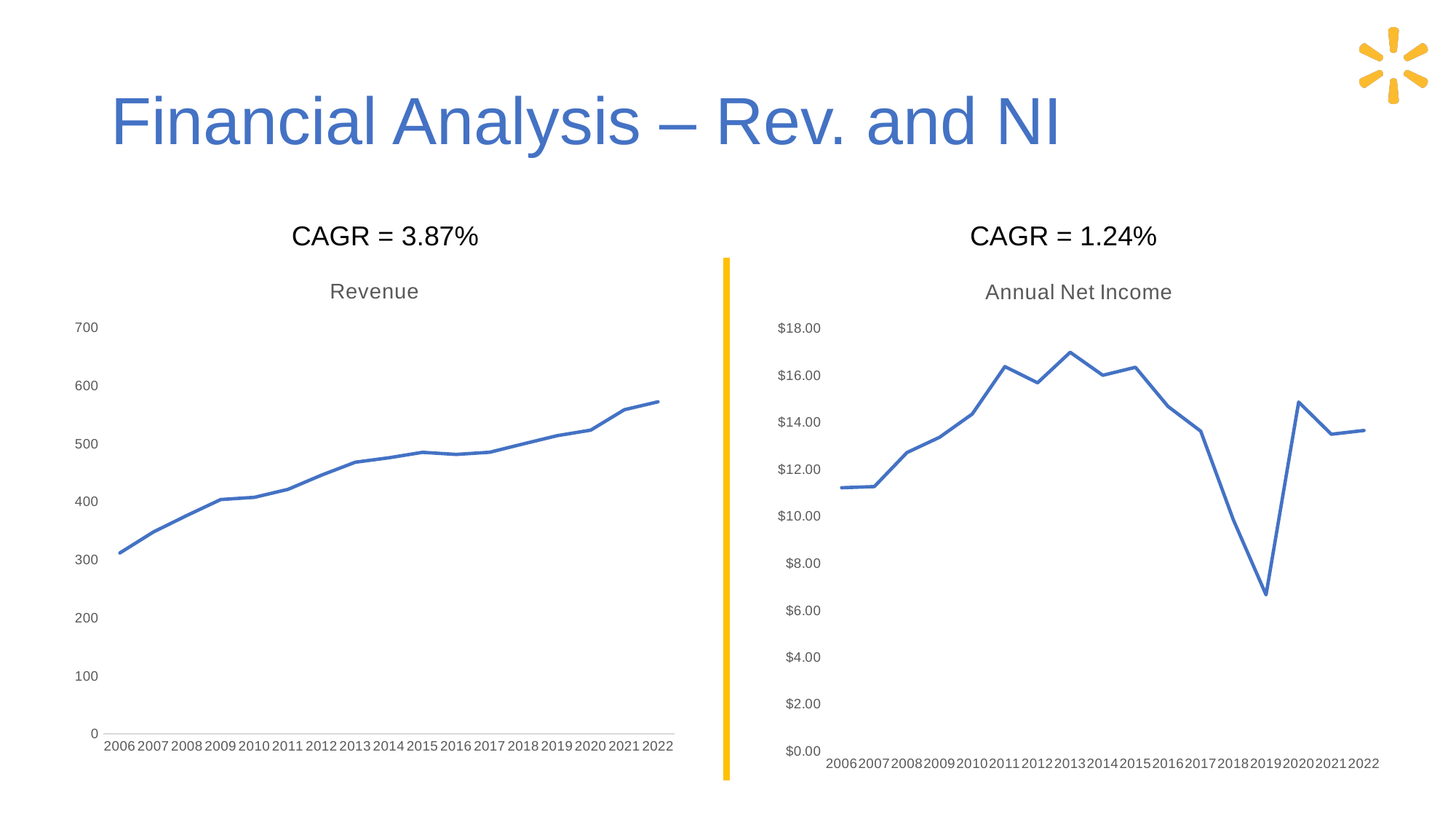
In the Annual Net Income chart, is the value for 2019 greater or less than $8.00? less What kind of chart is the Revenue chart? line chart In the Revenue chart, is the value for 2022 greater or less than 500? greater In the Revenue chart, do values generally rise or fall from 2006 to 2022? rise What CAGR is shown above the Revenue chart? 3.87% How many years are plotted on the Annual Net Income chart? 17 In the Annual Net Income chart, which year has the lowest net income? 2019 In the Revenue chart, is the value for 2006 greater or less than 400? less In the Annual Net Income chart, which year has the higher net income, 2013 or 2019? 2013 In the Annual Net Income chart, which year has the highest net income? 2013 In the Revenue chart, which year has the lowest revenue? 2006 In the Revenue chart, which year has the highest revenue? 2022